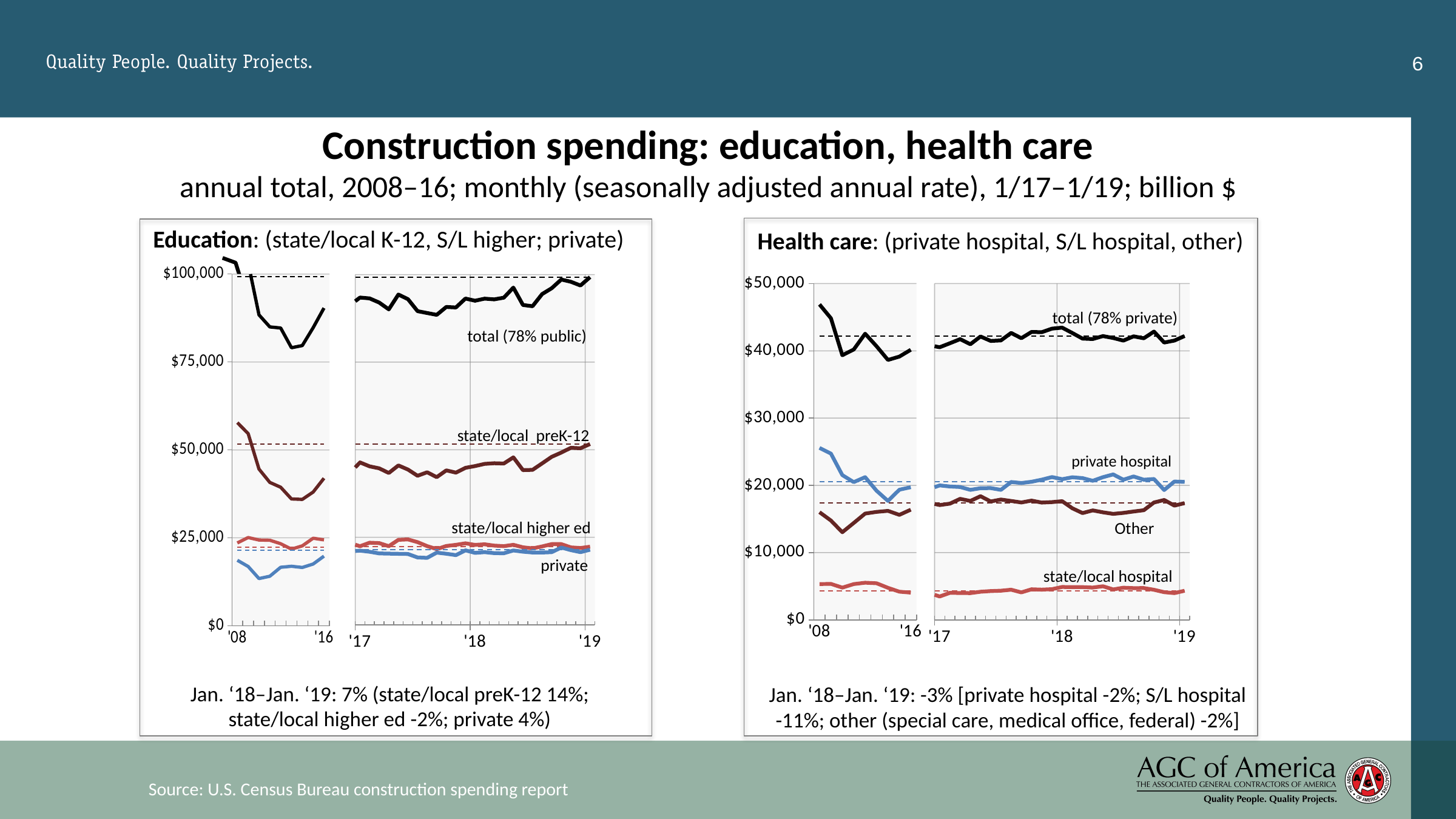
On the Health care chart, is the private hospital value in '08 greater or less than $20,000? greater On the Education chart, is the total value in '08 greater or less than $100,000? greater On the Health care chart, which is larger in '19: private hospital or state/local hospital? private hospital According to the note under the Education chart, what was the change from Jan. '18 to Jan. '19? 7% How many labelled series are plotted on the Education chart? 4 On the Health care chart, what share of the total is private, according to the total line's label? 78% What kind of chart is the Education chart? line chart How many labelled series are plotted on the Health care chart? 4 On the Education chart, is the total value in '16 greater or less than $100,000? less